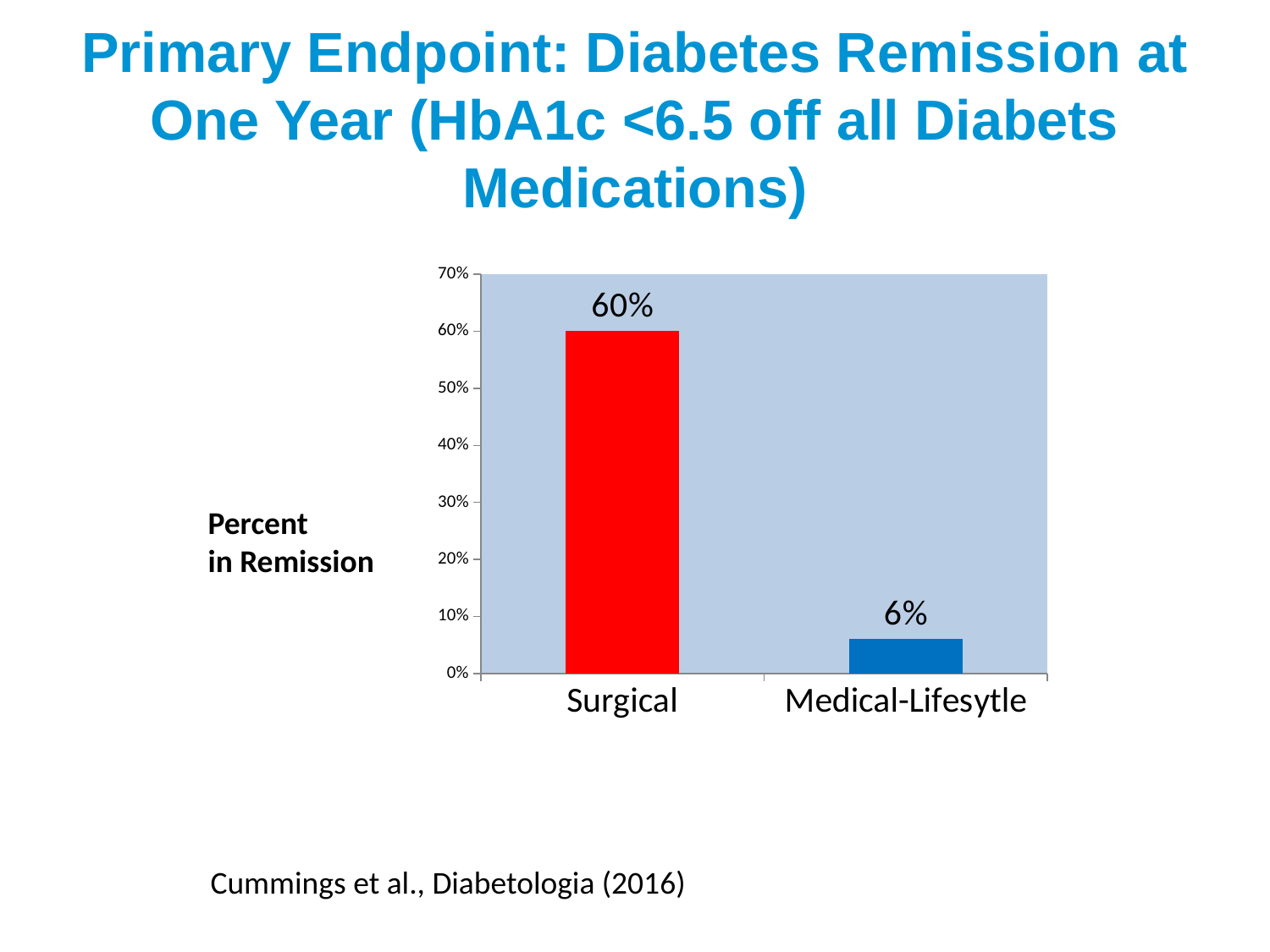
How many categories are shown on the chart? 2 Which group has the highest percent in remission? Surgical Is the value for Medical-Lifestyle greater or less than 10%? less What kind of chart is shown on the slide? Bar chart Which group has the lowest percent in remission? Medical-Lifestyle What is the percent in remission for the Surgical group? 60% Which group has a larger percent in remission, Surgical or Medical-Lifestyle? Surgical What is the difference in percent in remission between the Surgical and Medical-Lifestyle groups? 54% What colour is the bar for the Surgical group? Red What is the label on the vertical axis of the chart? Percent in Remission Is the value for Surgical greater or less than 50%? greater What is the percent in remission for the Medical-Lifestyle group? 6%